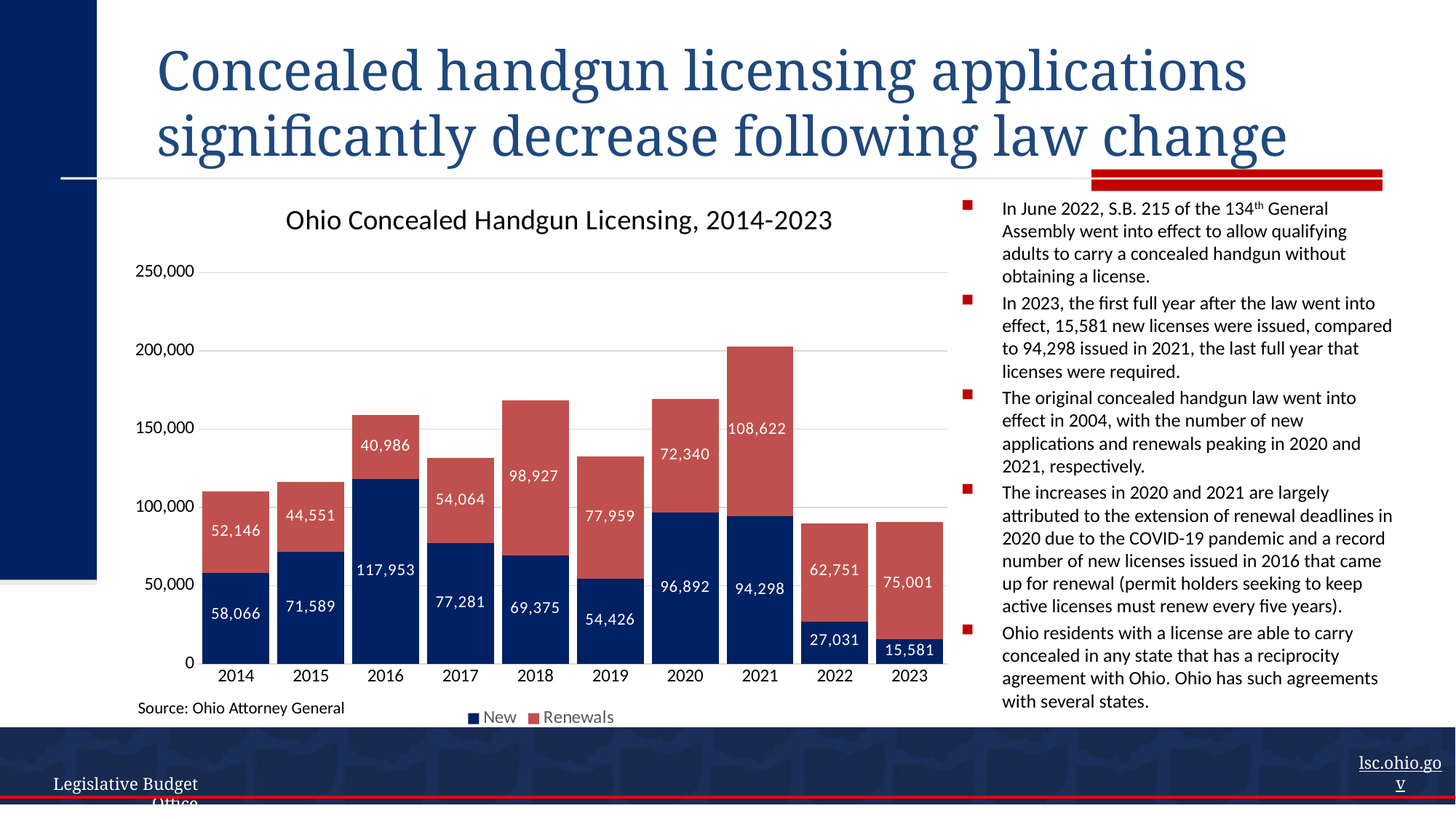
What is the difference between New licenses in 2021 and New licenses in 2023? 78,717 Do the values for New licenses rise or fall from 2021 to 2023? Fall What is the value for New licenses in 2016? 117,953 What is the total of the stacked bar for 2021? 202,920 What is the value for Renewals in 2021? 108,622 How many series does the legend list? 2 Which is larger in 2018, New licenses or Renewals? Renewals What kind of chart is shown on the slide? Stacked bar chart What is the value for New licenses in 2023? 15,581 Which year has the highest value for New licenses? 2016 Which year has the lowest value for Renewals? 2016 How many years are shown on the x axis? 10